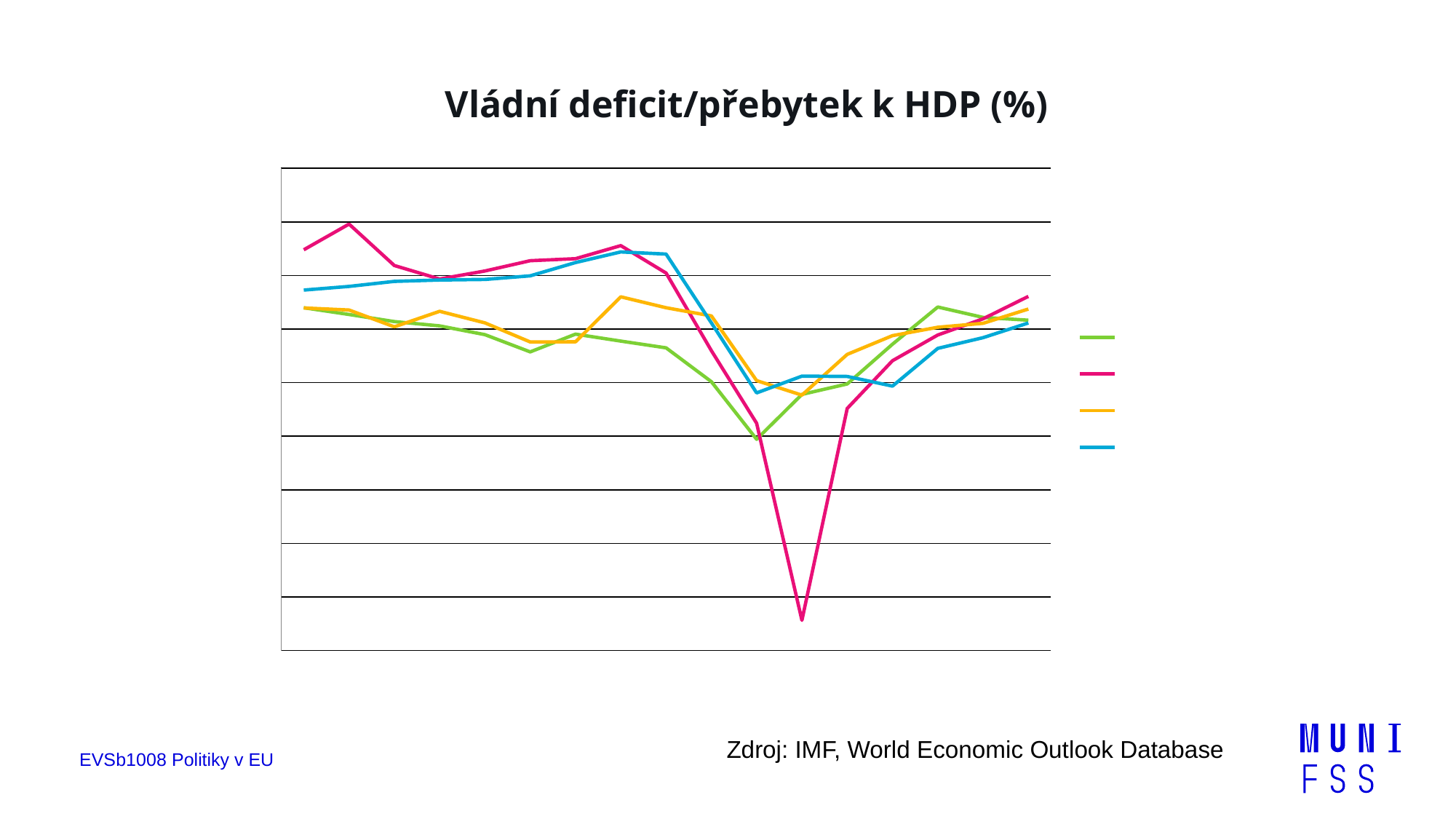
What kind of chart is shown on the slide? line chart What source is cited below the chart? IMF, World Economic Outlook Database How many series does the legend list? 4 Which coloured line drops to the lowest point on the chart? the pink line What is the title of the chart? Vládní deficit/přebytek k HDP (%)